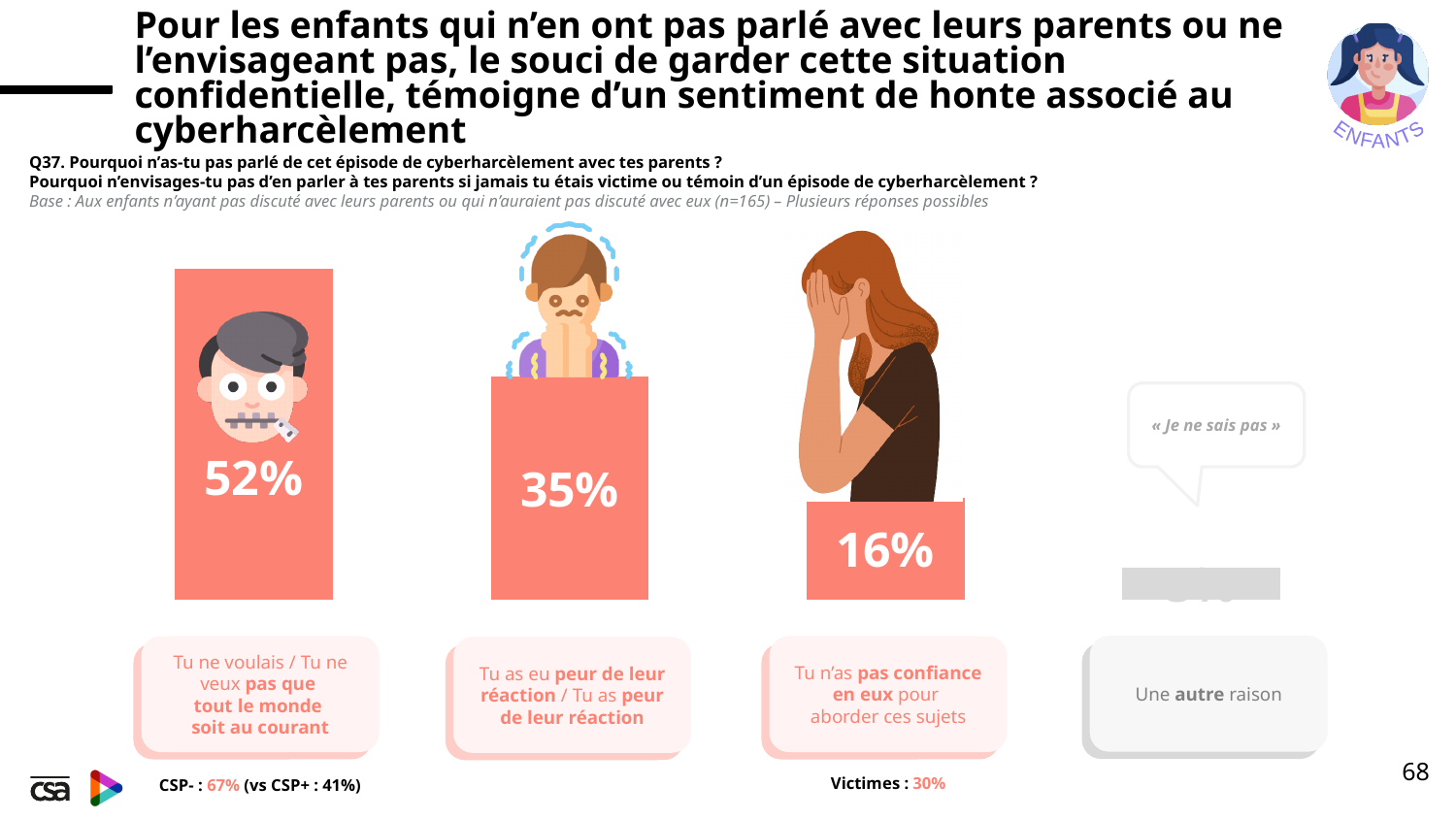
What percentage of children said they did not want everyone to know ("pas que tout le monde soit au courant")? 52% What percentage of children said they do not trust their parents to discuss these subjects ("pas confiance en eux")? 16% Do the labelled percentages rise or fall from left to right across the first three bars? fall According to the note under the first bar, what is the percentage for CSP- children? 67% What is the difference in percentage points between "peur de leur réaction" and "pas confiance en eux"? 19 percentage points Which is larger: the share for "peur de leur réaction" or the share for "pas confiance en eux"? peur de leur réaction How many reason categories are shown as bars on the chart? 4 Which reason has the highest percentage on the chart? Tu ne voulais / Tu ne veux pas que tout le monde soit au courant What is the difference in percentage points between "pas que tout le monde soit au courant" and "peur de leur réaction"? 17 percentage points What kind of chart is used to show the reasons? bar chart According to the note under the third bar, what is the percentage among victims ("Victimes")? 30% What percentage of children cited fear of their parents' reaction ("peur de leur réaction")? 35%